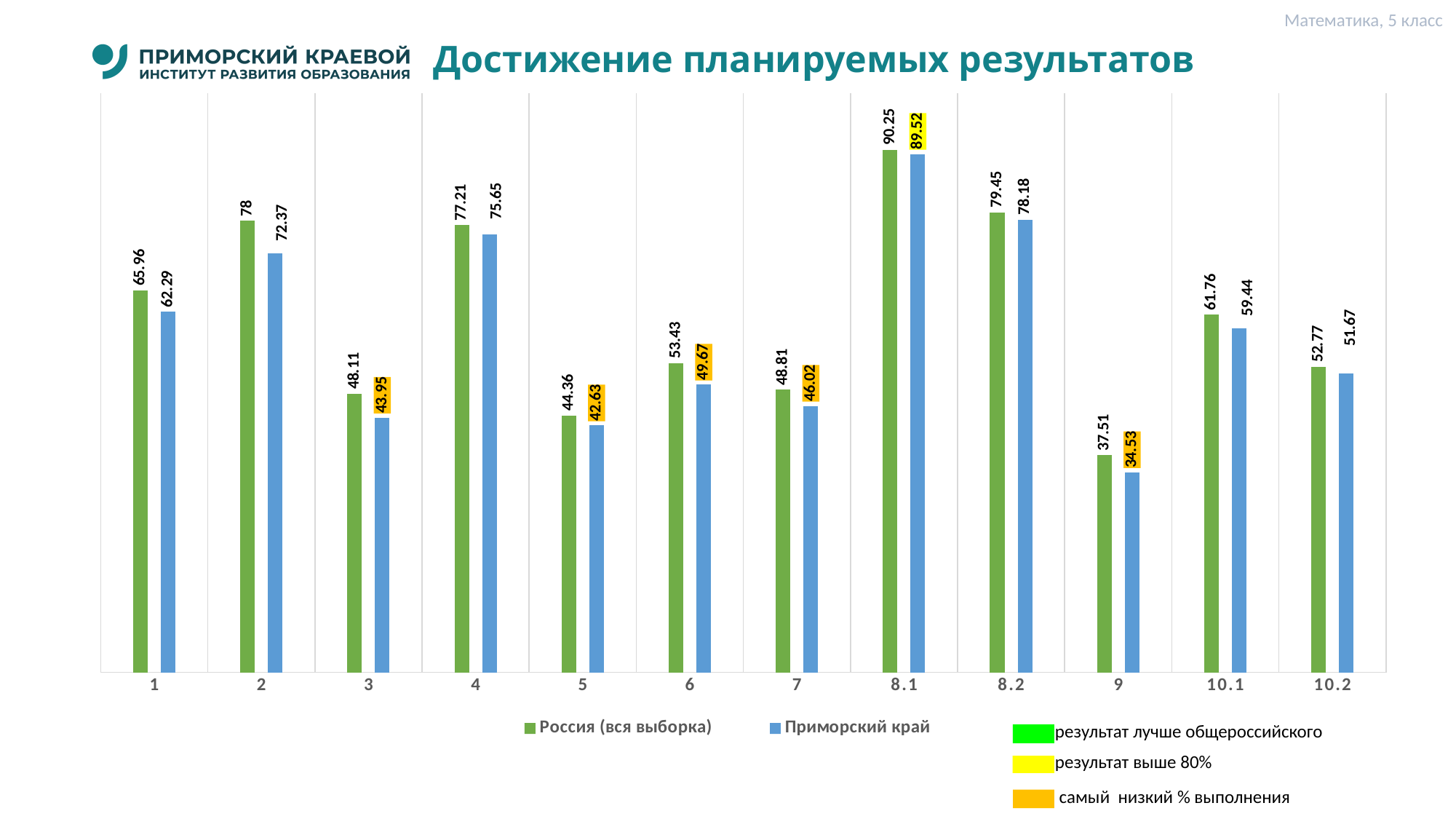
Which colour represents the series Приморский край? Blue What is the value for Приморский край for category 9? 34.53 Which category has the highest value for Приморский край? 8.1 What kind of chart is shown on the slide? Bar chart Which is larger for category 6: the value for Россия (вся выборка) or for Приморский край? Россия (вся выборка) How many categories are shown on the x axis? 12 What is the value for Россия (вся выборка) for category 8.1? 90.25 How many series does the chart legend list? 2 What is the value for Приморский край for category 2? 72.37 What is the title of the slide? Достижение планируемых результатов Which category has the lowest value for Россия (вся выборка)? 9 What is the difference between the Россия (вся выборка) and Приморский край values for category 3? 4.16